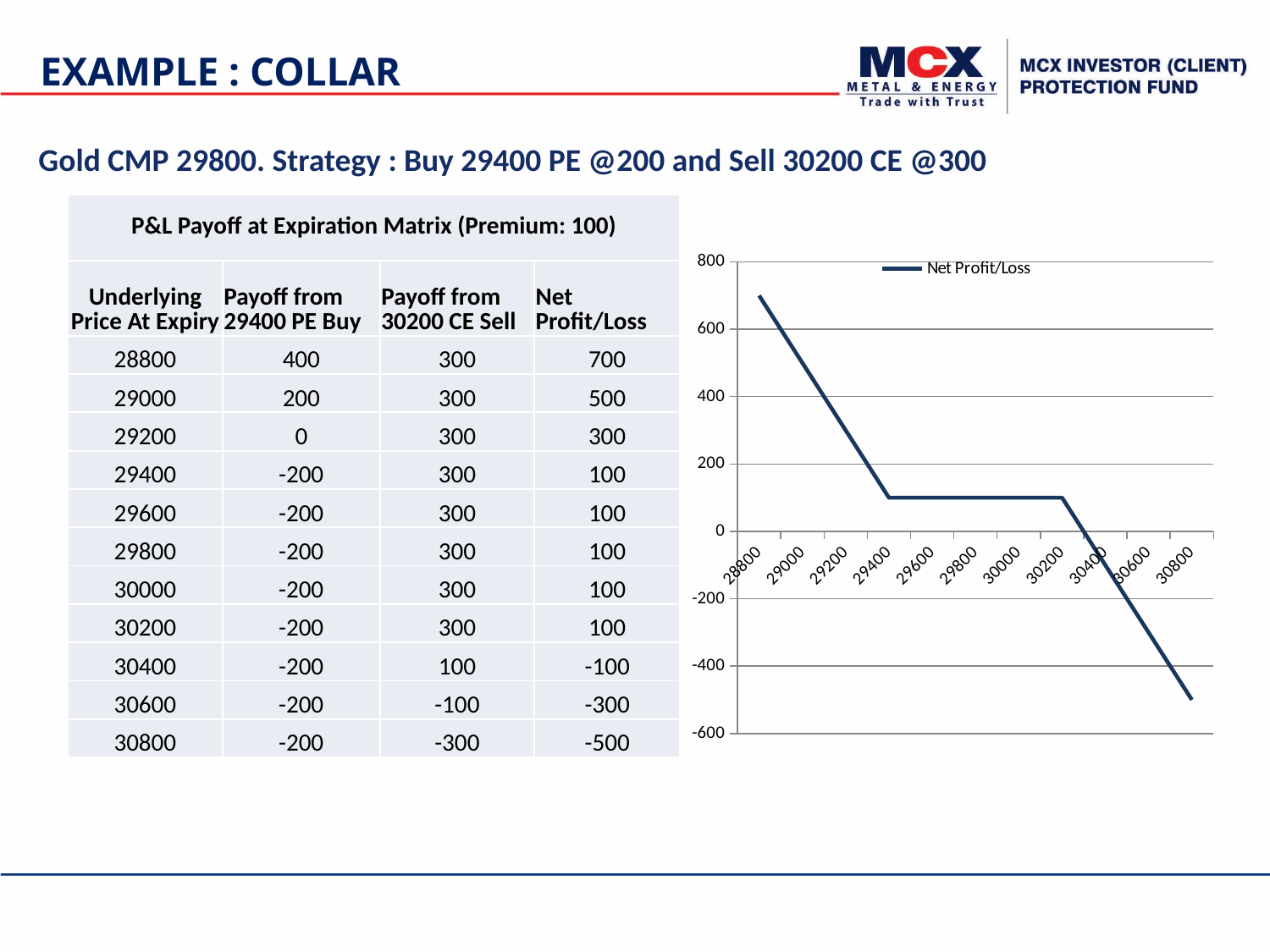
Is the Net Profit/Loss at 30800 greater or less than -400? less Is the Net Profit/Loss at 28800 greater or less than 600? greater At which underlying price is the Net Profit/Loss lowest? 30800 At which underlying price is the Net Profit/Loss highest? 28800 Which has the larger Net Profit/Loss, an underlying price of 29200 or 30400? 29200 What kind of chart is shown on the slide? line chart Is the Net Profit/Loss at 29000 greater or less than 400? greater How many underlying price points are plotted along the x axis of the chart? 11 What is the Net Profit/Loss at an underlying price of 28800? 700 Does the Net Profit/Loss line rise or fall overall as the underlying price increases from 28800 to 30800? fall What is the name of the series shown in the chart legend? Net Profit/Loss How many series does the chart's legend list? 1